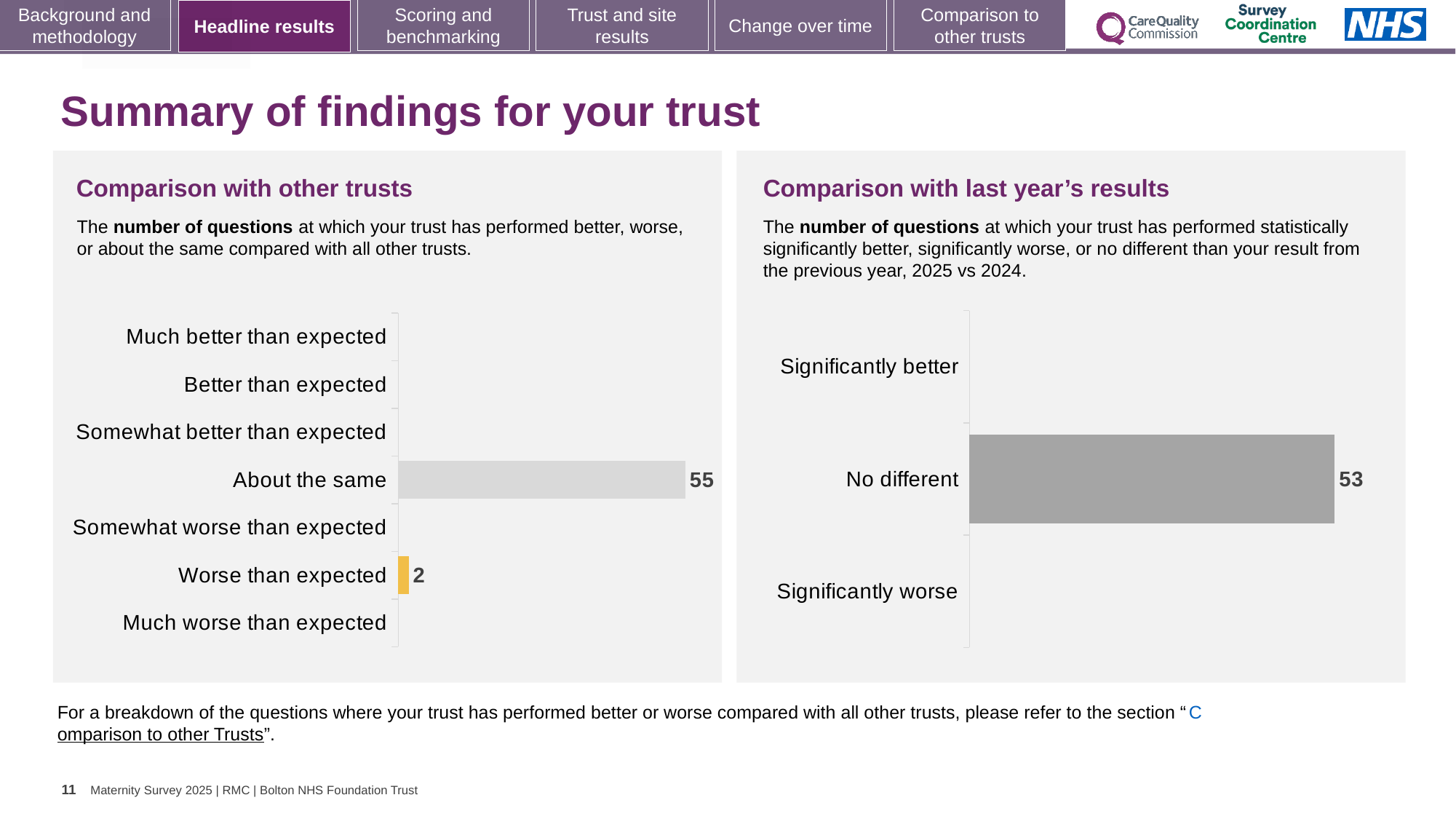
In the 'Comparison with other trusts' chart, what is the value for 'Worse than expected'? 2 In the 'Comparison with other trusts' chart, what is the difference between the values for 'About the same' and 'Worse than expected'? 53 How many categories are listed on the 'Comparison with last year's results' chart? 3 How many categories are listed on the 'Comparison with other trusts' chart? 7 What kind of chart is the 'Comparison with last year's results' chart? Bar chart In the 'Comparison with last year's results' chart, what is the value for 'No different'? 53 In the 'Comparison with last year's results' chart, which category has the highest value? No different In the 'Comparison with other trusts' chart, which category has the highest value? About the same What is the title of the chart on the left side of the slide? Comparison with other trusts In the 'Comparison with other trusts' chart, what is the value for 'About the same'? 55 In the 'Comparison with other trusts' chart, what colour is the bar for 'Worse than expected'? Yellow In the 'Comparison with other trusts' chart, which is larger: the value for 'About the same' or the value for 'Worse than expected'? About the same